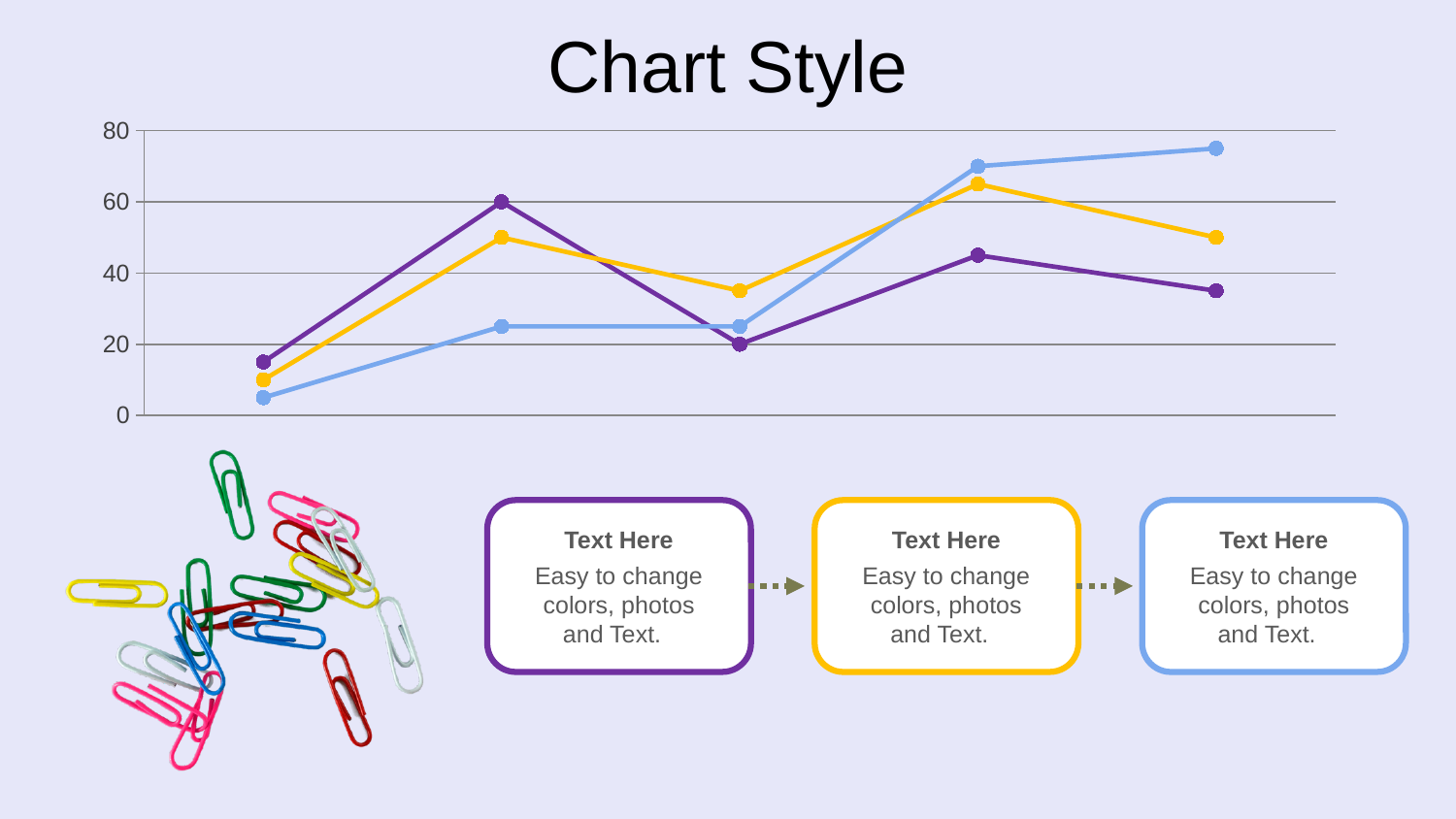
Is the value of the blue line at its last (rightmost) point greater or less than 60? greater How many lines are plotted on the chart? 3 Does the blue line rise or fall between its fourth and fifth points? rise What kind of chart is shown on the slide? line chart What is the value of the purple line at its second point from the left? 60 What is the value of the purple line at its third point from the left? 20 At the second point from the left, which line is higher: the purple line or the blue line? the purple line Which line has the highest value at the rightmost point? the blue line Which line has the lowest value at the leftmost point? the blue line Is the value of the purple line at its last (rightmost) point greater or less than 40? less How many data points does each line on the chart have? 5 Is the value of the yellow line at its first (leftmost) point greater or less than 20? less